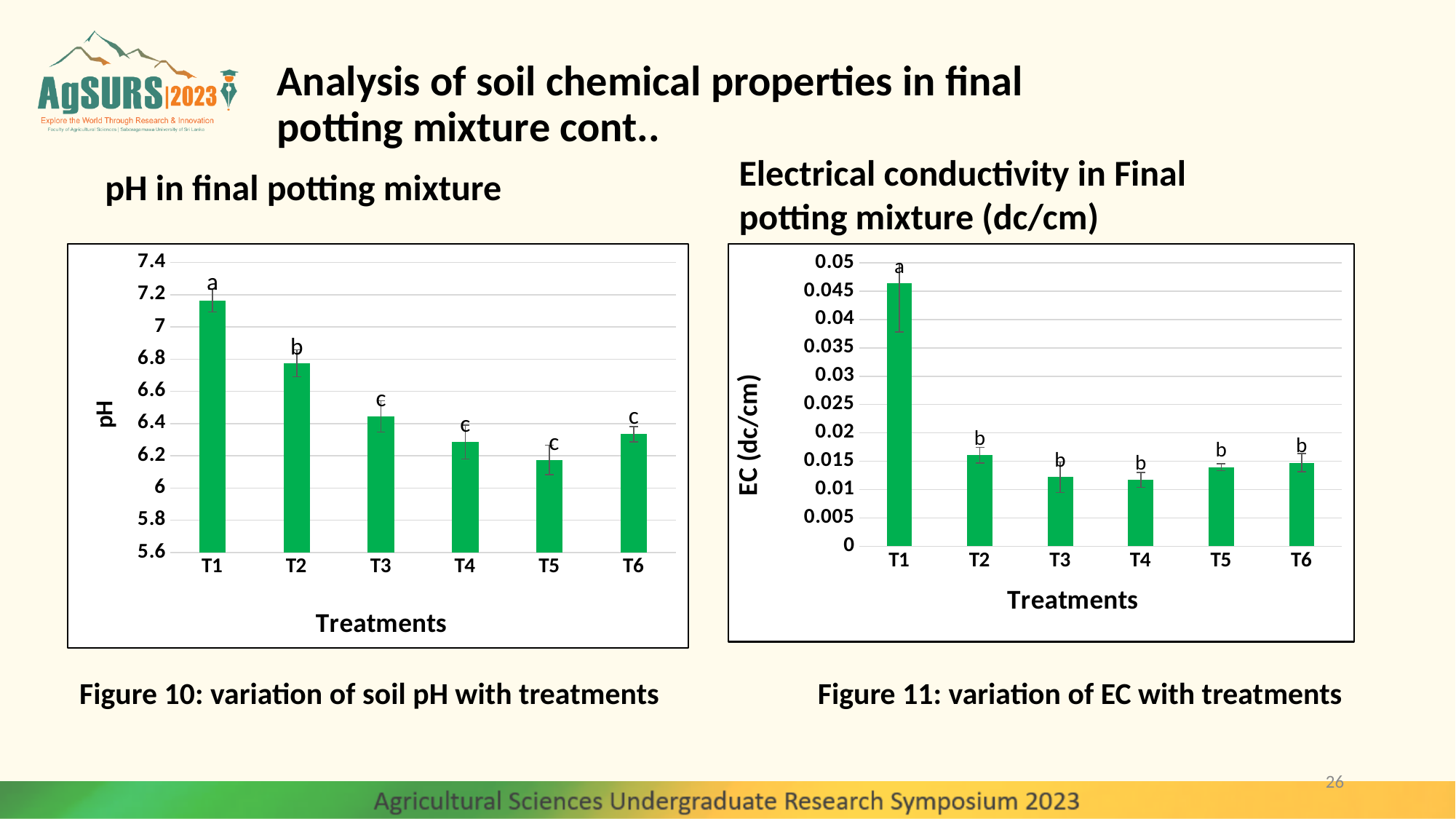
What kind of chart is the Electrical conductivity in Final potting mixture chart? bar chart In the Electrical conductivity in Final potting mixture chart, is the value for T1 greater or less than 0.04? greater In the Electrical conductivity in Final potting mixture chart, which treatment has the highest EC? T1 In the pH in final potting mixture chart, is the value for T1 greater or less than 7? greater In the Electrical conductivity in Final potting mixture chart, is the value for T2 greater or less than 0.02? less In the pH in final potting mixture chart, how many treatments are shown on the x axis? 6 In the pH in final potting mixture chart, which treatment has the highest pH? T1 In the pH in final potting mixture chart, which is larger, the pH for T3 or for T4? T3 In the Electrical conductivity in Final potting mixture chart, what is the label on the y axis? EC (dc/cm) In the pH in final potting mixture chart, do the values rise or fall from T1 to T5? fall